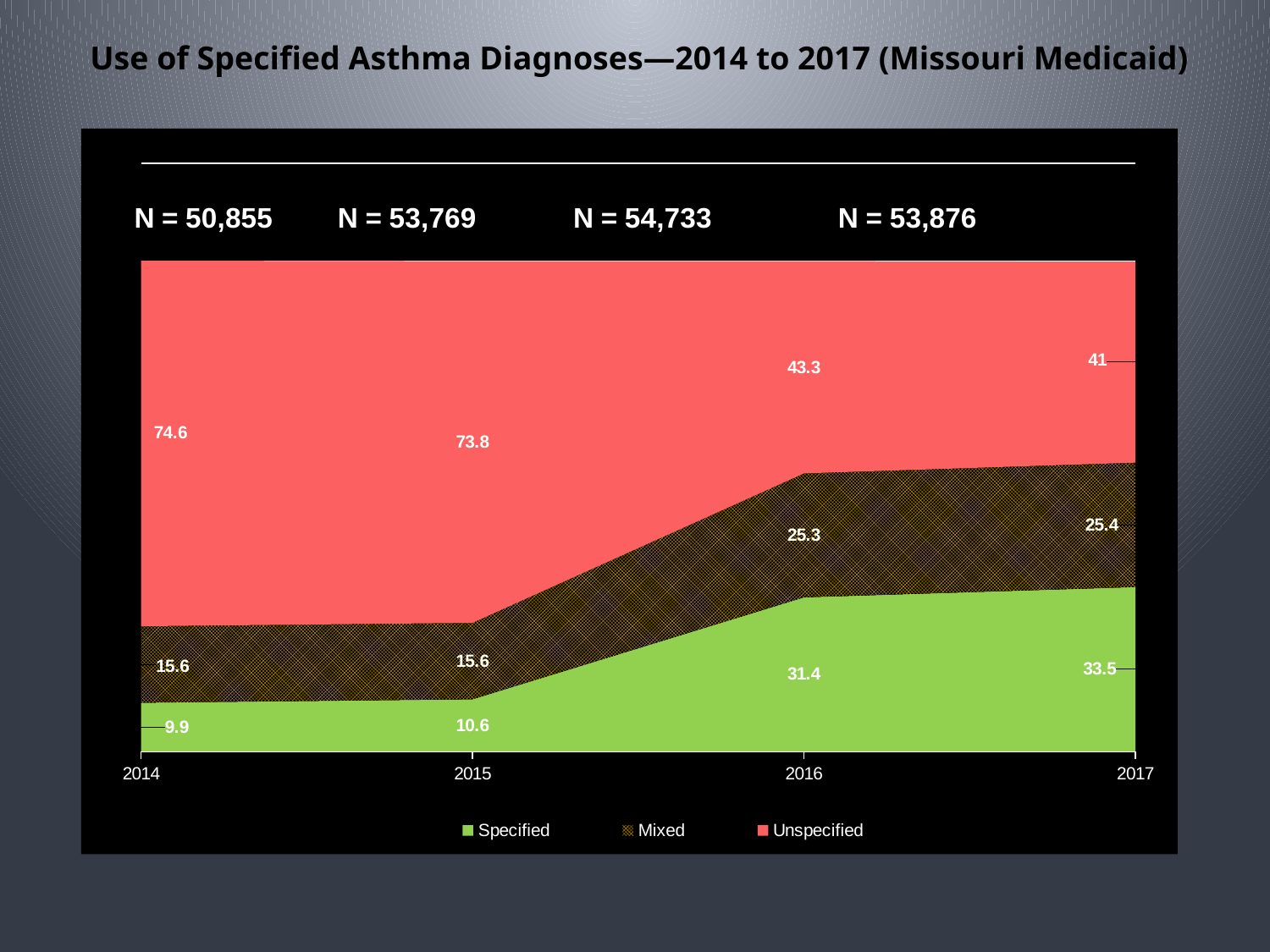
How many years are shown on the x axis? 4 In which year is the Specified value highest? 2017 What is the value for Unspecified in 2016? 43.3 In which year is the Unspecified value lowest? 2017 Which is larger in 2016, the Specified value or the Mixed value? Specified Does the Specified value rise or fall from 2014 to 2017? Rise What is the value for Specified in 2014? 9.9 What is the difference between the Unspecified values for 2014 and 2017? 33.6 How many series does the legend list? 3 What is the value for Mixed in 2017? 25.4 What is the value for Unspecified in 2015? 73.8 What kind of chart is this? Stacked area chart